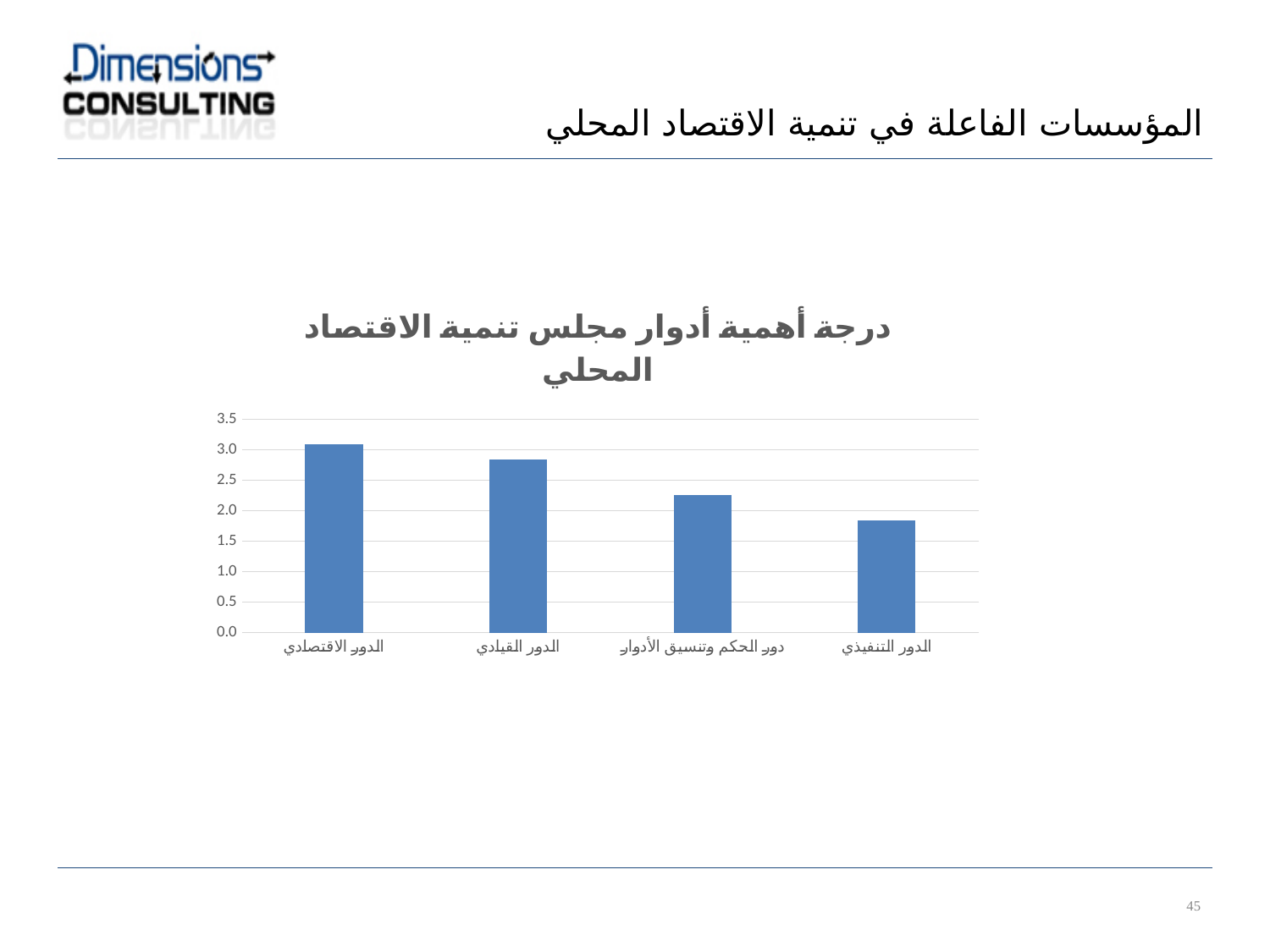
Which is larger, the value for الدور القيادي or the value for دور الحكم وتنسيق الأدوار? الدور القيادي What kind of chart is shown on the slide? bar chart How many categories are plotted in the chart? 4 Is the value for الدور التنفيذي greater or less than 2.0? less Is the value for دور الحكم وتنسيق الأدوار greater or less than 2.0? greater Do the bar values rise or fall from left to right along the x axis? fall Is the value for الدور الاقتصادي greater or less than 3.0? greater What is the title of the chart? درجة أهمية أدوار مجلس تنمية الاقتصاد المحلي Which category has the highest value in the chart? الدور الاقتصادي Which is larger, the value for الدور الاقتصادي or the value for الدور التنفيذي? الدور الاقتصادي Which category has the lowest value in the chart? الدور التنفيذي